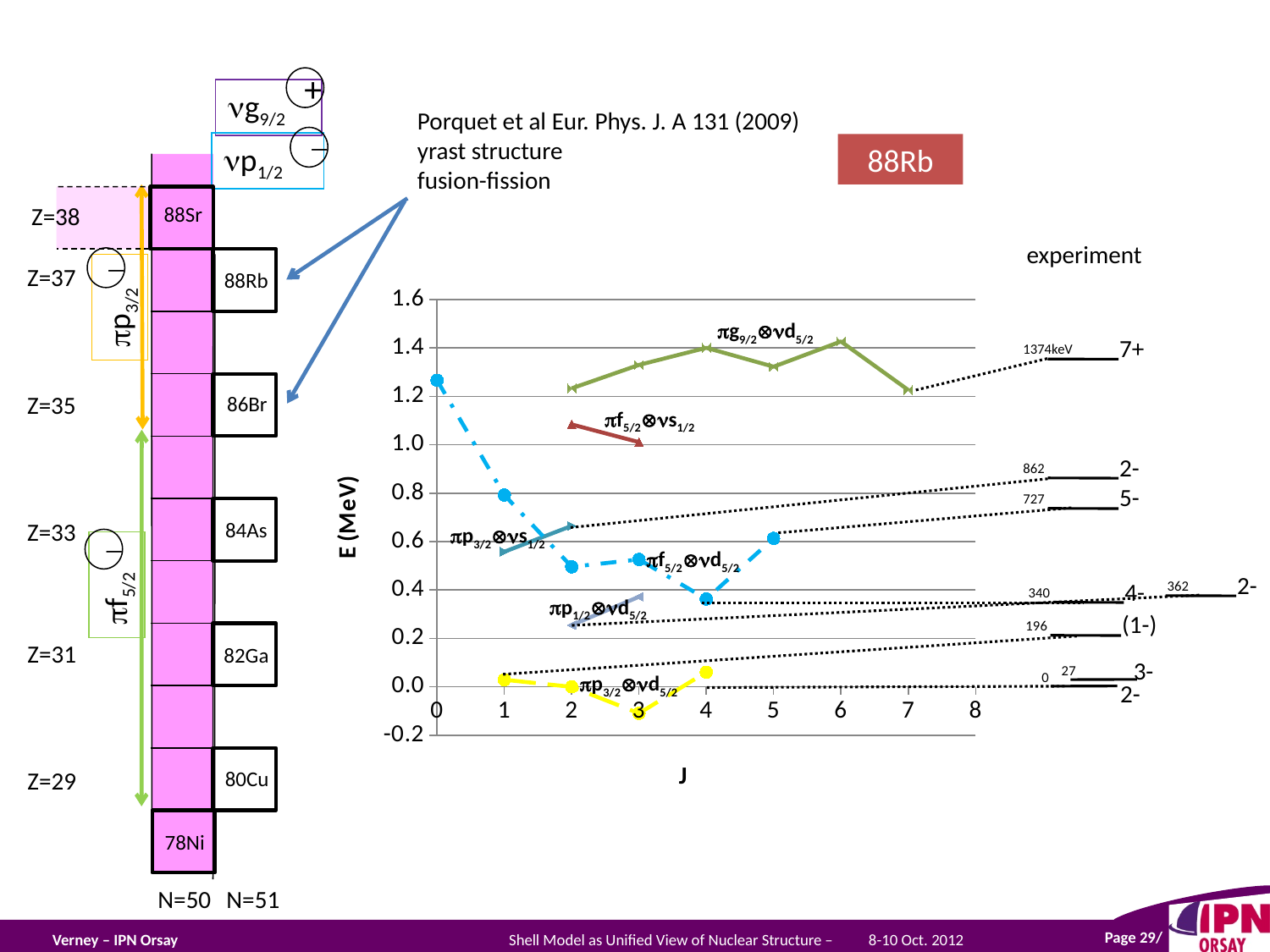
What is the label of the x axis of the chart? J How many data points does the πg9/2⊗νd5/2 series have? 6 Is the value of the πf5/2⊗νd5/2 series at J=4 greater or less than 0.6? less What kind of chart is shown on the slide? line chart At which J does the πf5/2⊗νd5/2 series reach its highest value? 0 What is the label of the y axis of the chart? E (MeV) At which J does the πf5/2⊗νd5/2 series reach its lowest value? 4 Is the value of the πf5/2⊗νd5/2 series at J=0 greater or less than 1.0? greater Is the value of the πp3/2⊗νd5/2 series at J=3 greater or less than 0.0? less At J=4, which series has the larger value: πg9/2⊗νd5/2 or πf5/2⊗νd5/2? πg9/2⊗νd5/2 Does the πf5/2⊗νd5/2 series rise or fall from J=0 to J=2? fall